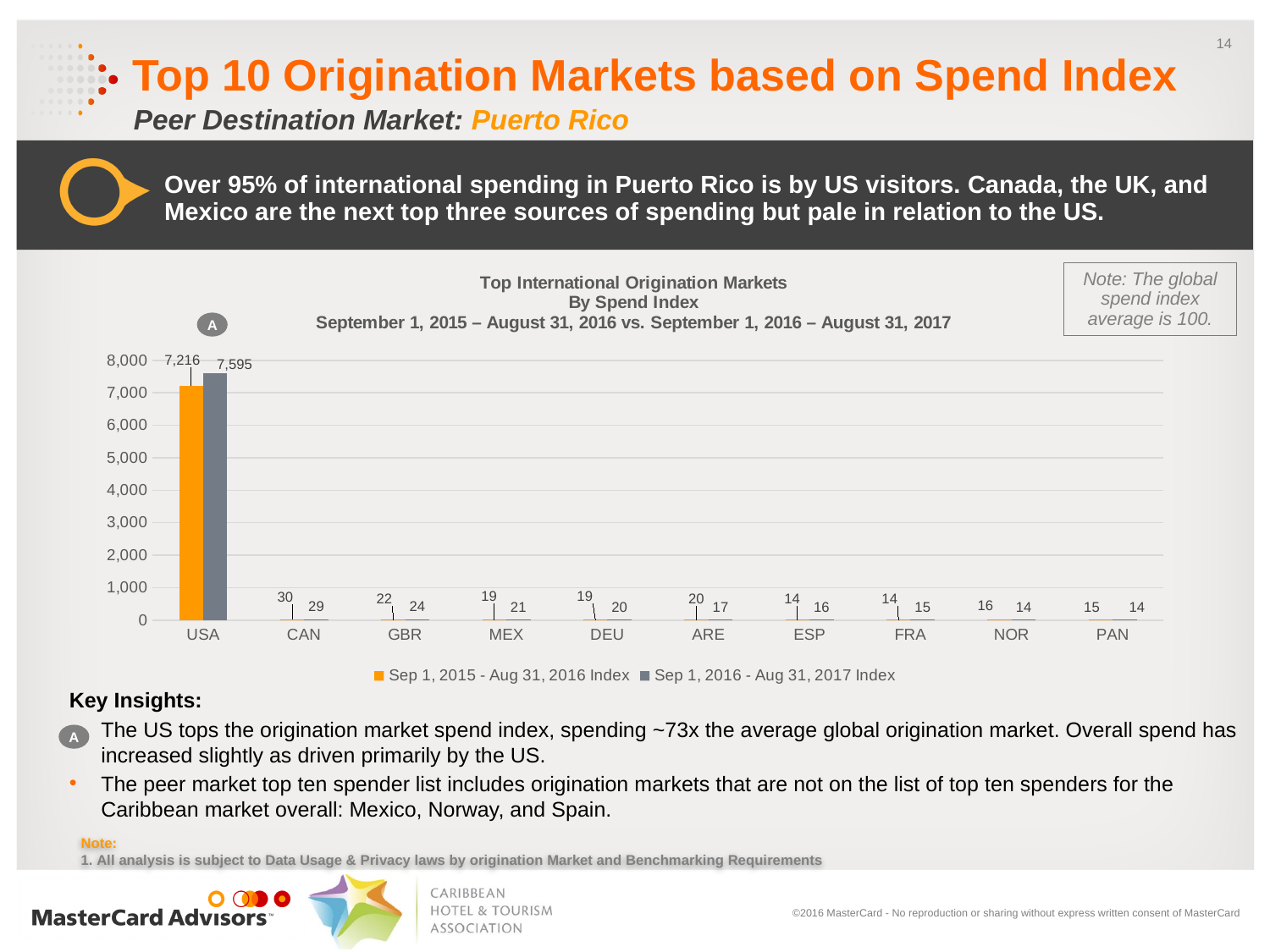
Is the Sep 1, 2015 - Aug 31, 2016 Index value for USA greater or less than 7,000? greater What is the Sep 1, 2015 - Aug 31, 2016 Index value for CAN? 30 What is the difference between the Sep 1, 2015 - Aug 31, 2016 Index values for CAN and GBR? 8 How many origination markets are shown on the x axis of the chart? 10 What is the Sep 1, 2016 - Aug 31, 2017 Index value for USA? 7,595 Which origination market has the highest Sep 1, 2016 - Aug 31, 2017 Index value? USA What is the difference between the USA's Sep 1, 2016 - Aug 31, 2017 Index and its Sep 1, 2015 - Aug 31, 2016 Index? 379 How many series does the chart's legend list? 2 For NOR, which is larger: the Sep 1, 2015 - Aug 31, 2016 Index or the Sep 1, 2016 - Aug 31, 2017 Index? Sep 1, 2015 - Aug 31, 2016 Index What type of chart is used to show the spend index by origination market? Bar chart What is the Sep 1, 2016 - Aug 31, 2017 Index value for GBR? 24 What is the Sep 1, 2015 - Aug 31, 2016 Index value for ARE? 20